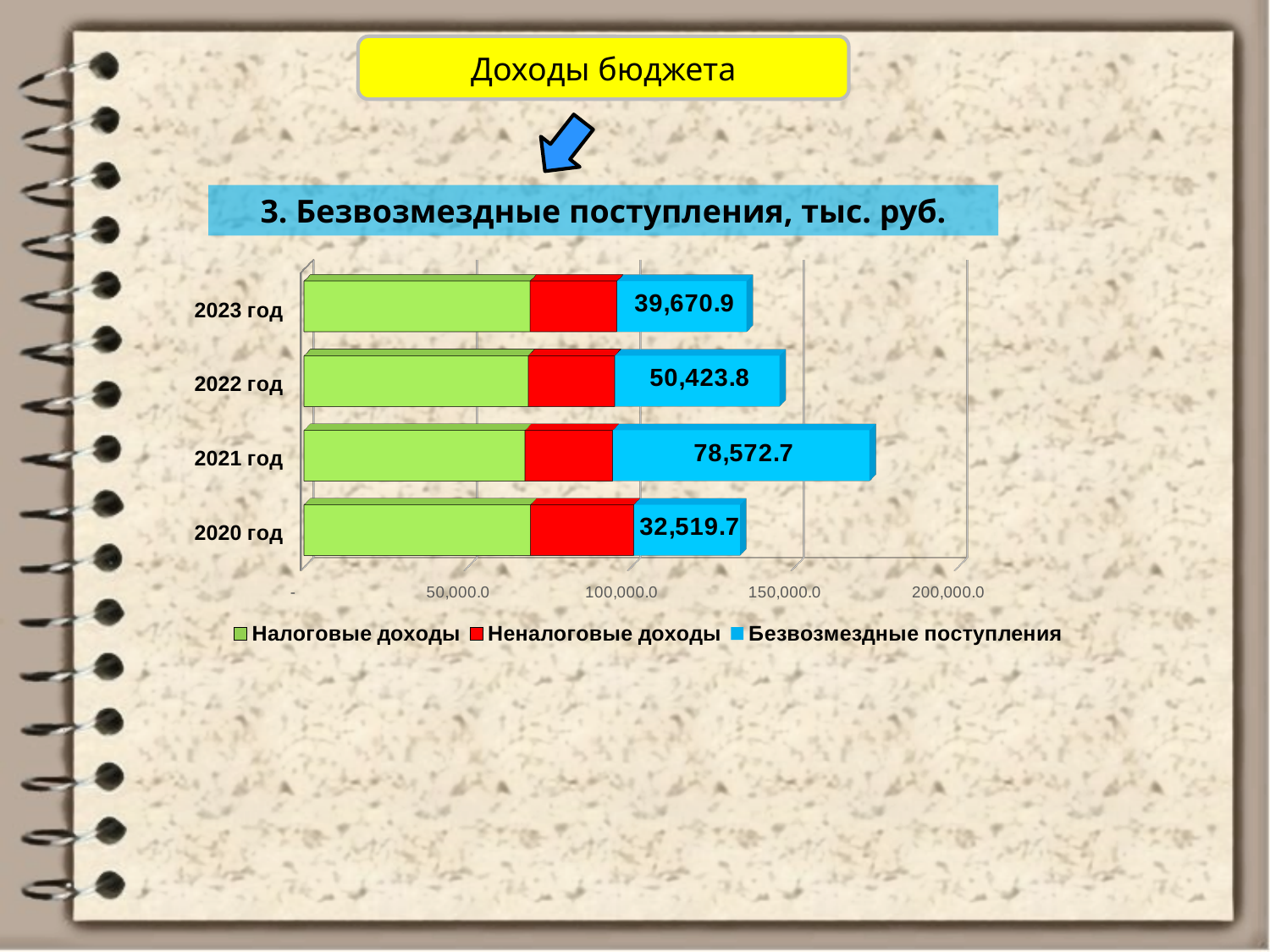
Is the total length of the stacked bar for 2021 год greater or less than 150,000.0? greater What is the value of Безвозмездные поступления for 2021 год? 78,572.7 What is the difference between the Безвозмездные поступления values for 2021 год and 2020 год? 46,053.0 How many years are shown on the chart? 4 In which year is the value of Безвозмездные поступления the highest? 2021 год In which year is the value of Безвозмездные поступления the lowest? 2020 год What type of chart is shown on the slide? Stacked bar chart How many series does the legend list? 3 Which year has a larger value of Безвозмездные поступления, 2022 год or 2023 год? 2022 год What is the value of Безвозмездные поступления for 2020 год? 32,519.7 Is the value of Налоговые доходы for 2023 год greater or less than 50,000.0? greater What is the value of Безвозмездные поступления for 2023 год? 39,670.9